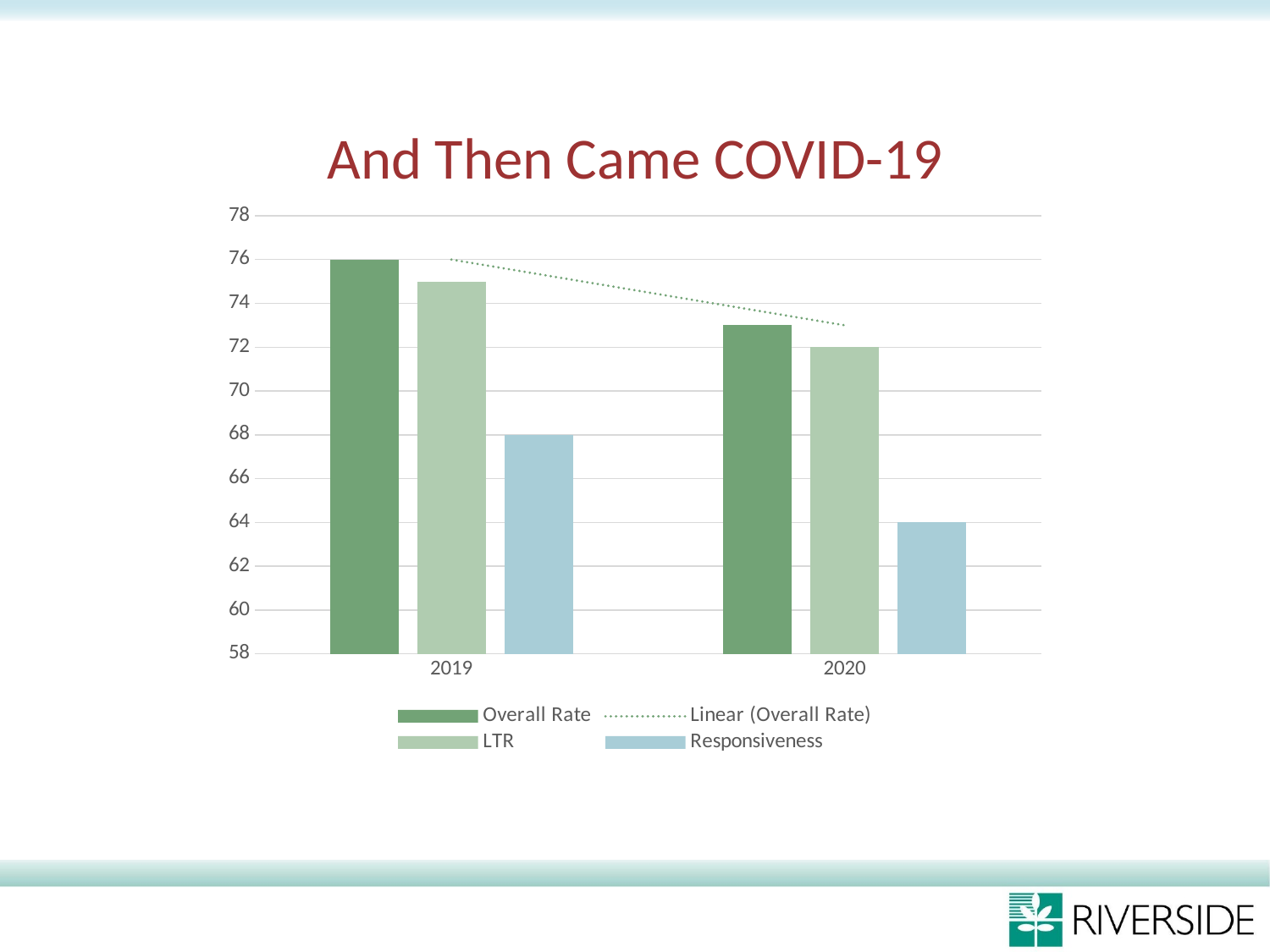
What is the Overall Rate value for 2019? 76 What is the LTR value for 2020? 72 What is the Responsiveness value for 2020? 64 How many entries does the legend list? 4 Is the LTR value for 2019 greater or less than 74? greater Which bar is the lowest on the chart? Responsiveness in 2020 Which year has the higher Overall Rate, 2019 or 2020? 2019 Is the Overall Rate value for 2020 greater or less than 74? less By how much did Responsiveness fall from 2019 to 2020? 4 What is the Responsiveness value for 2019? 68 Does the Overall Rate rise or fall from 2019 to 2020? fall What kind of chart is shown on the slide? bar chart